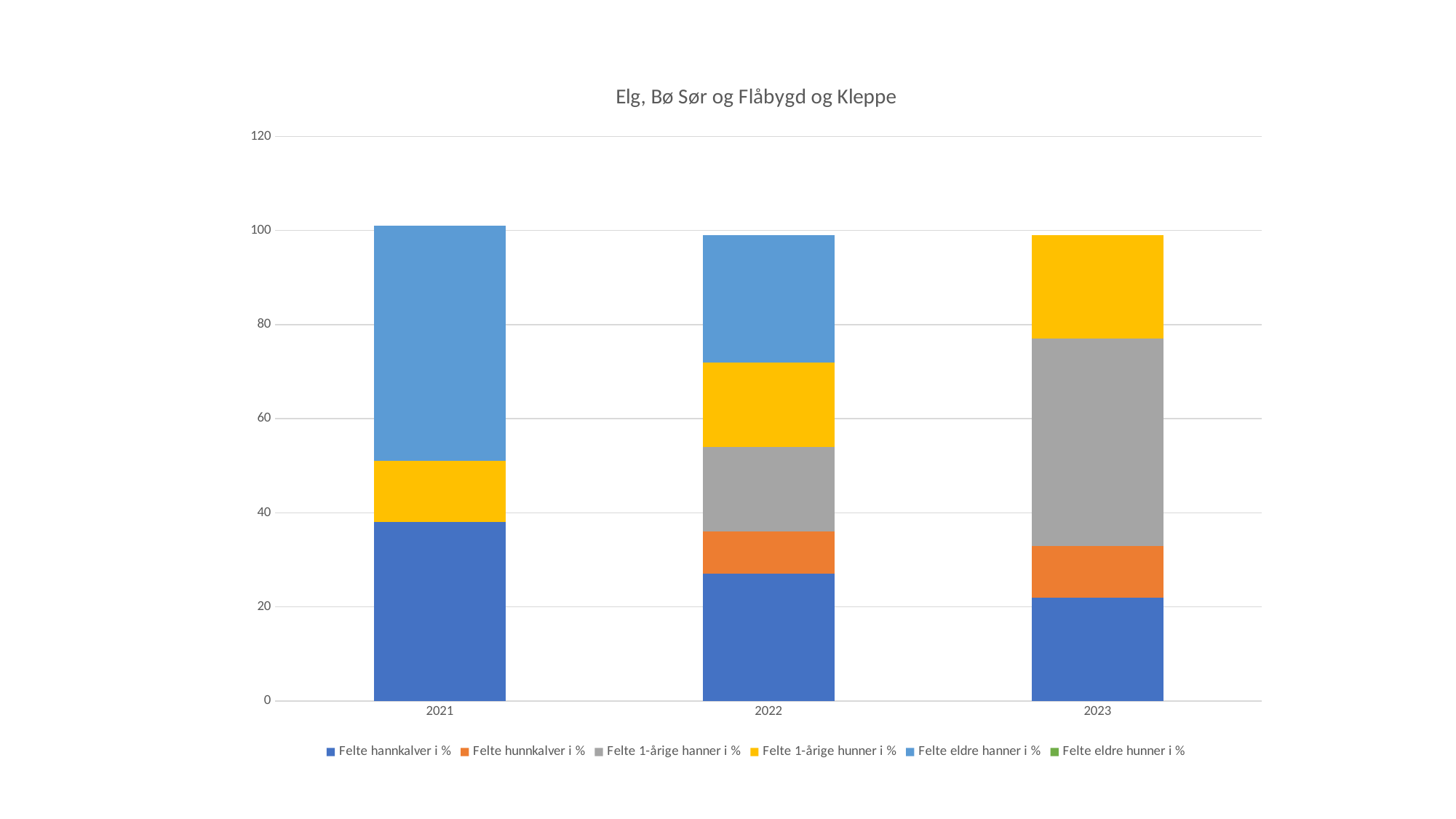
Is the value for Felte hannkalver i % in 2021 greater or less than 20? greater Is the value for Felte hannkalver i % in 2023 greater or less than 40? less What is the title of the chart? Elg, Bø Sør og Flåbygd og Kleppe How many years are shown on the x axis of the chart? 3 What kind of chart is shown on the slide? Stacked bar chart Which year has the largest Felte 1-årige hanner i % segment? 2023 Is the Felte eldre hanner i % segment larger in 2021 or in 2022? 2021 Is the total height of the stacked bar for 2021 greater or less than 80? greater How many series does the chart legend list? 6 Does the Felte hannkalver i % segment rise or fall from 2021 to 2023? Fall Which legend series does not appear as a visible segment in any of the bars? Felte eldre hunner i % Which year has the largest Felte hannkalver i % segment? 2021